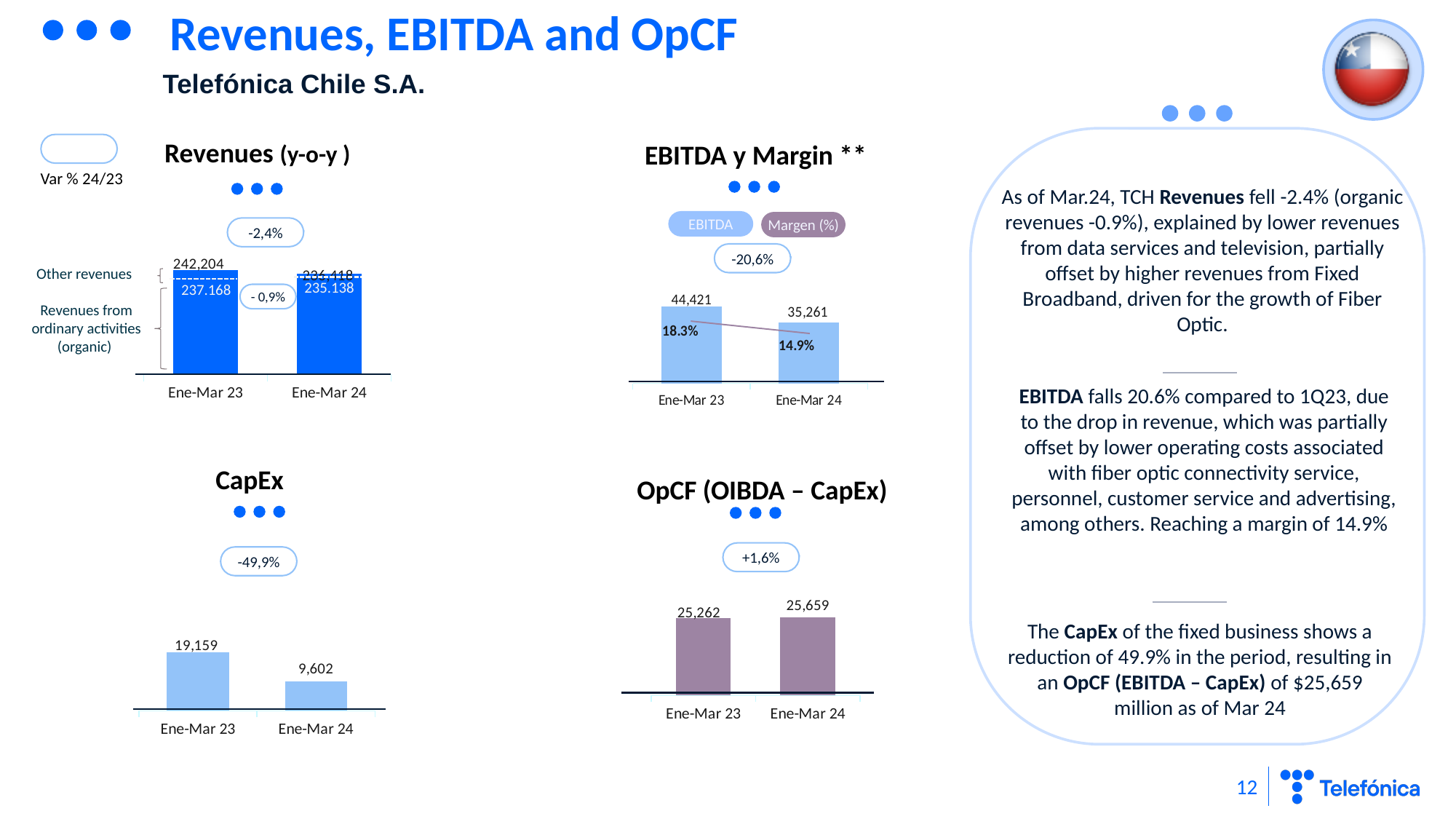
In the Revenues (y-o-y) chart, what is the revenue from ordinary activities (organic) for Ene-Mar 24? 235.138 In the EBITDA y Margin chart, what is the EBITDA value for Ene-Mar 24? 35,261 In the OpCF (OIBDA – CapEx) chart, which period has the higher value, Ene-Mar 23 or Ene-Mar 24? Ene-Mar 24 In the EBITDA y Margin chart, what is the margin (%) for Ene-Mar 24? 14.9% In the EBITDA y Margin chart, what is the margin (%) for Ene-Mar 23? 18.3% In the CapEx chart, what is the value for Ene-Mar 23? 19,159 In the EBITDA y Margin chart, what is the EBITDA value for Ene-Mar 23? 44,421 In the CapEx chart, what is the value for Ene-Mar 24? 9,602 In the Revenues (y-o-y) chart, what is the total revenue value for Ene-Mar 23? 242,204 In the OpCF (OIBDA – CapEx) chart, what is the value for Ene-Mar 24? 25,659 What kind of chart is the CapEx chart? Bar chart In the CapEx chart, what is the difference between the Ene-Mar 23 and Ene-Mar 24 values? 9,557